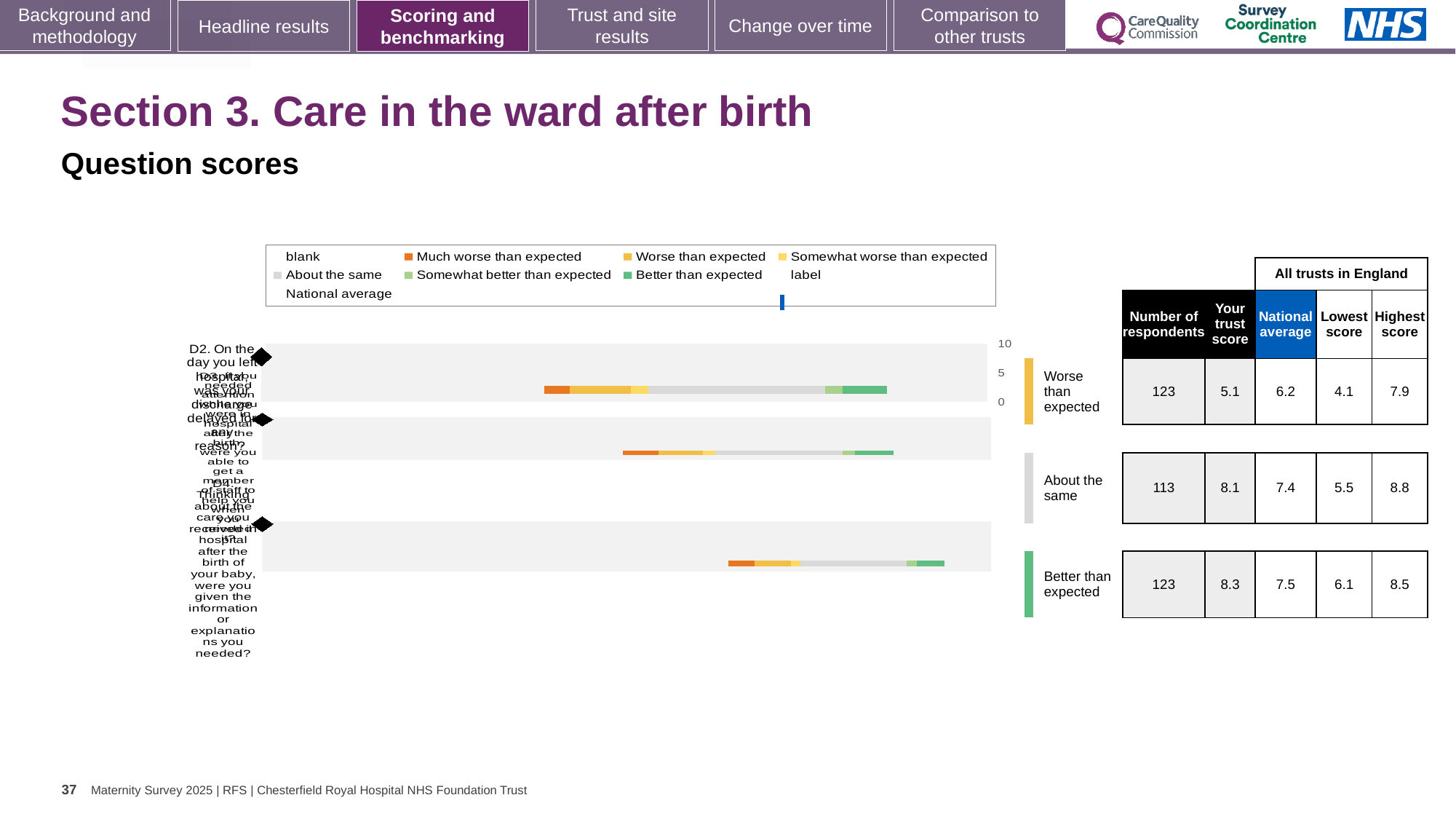
How many question rows (bars) are plotted in the chart? 3 For the first question row, which is larger: the trust score or the national average? the national average (6.2) Which question row has the lowest number of respondents in the table? the second row (About the same), 113 What kind of chart is shown on the slide? bar chart Which question row has the highest trust score in the table? the third row (Better than expected), 8.3 In the table, what is the national average for the second question row (rated 'About the same')? 7.4 In the table, what is the highest score for the third question row (rated 'Better than expected')? 8.5 For the first question row, what is the difference between the highest score (7.9) and the lowest score (4.1)? 3.8 Which rating label is shown next to the first question row in the table? Worse than expected In the table, what is the number of respondents for the first question row (rated 'Worse than expected')? 123 In the table, what is the trust score for the first question row (rated 'Worse than expected')? 5.1 What colour does the legend use for 'Much worse than expected'? orange